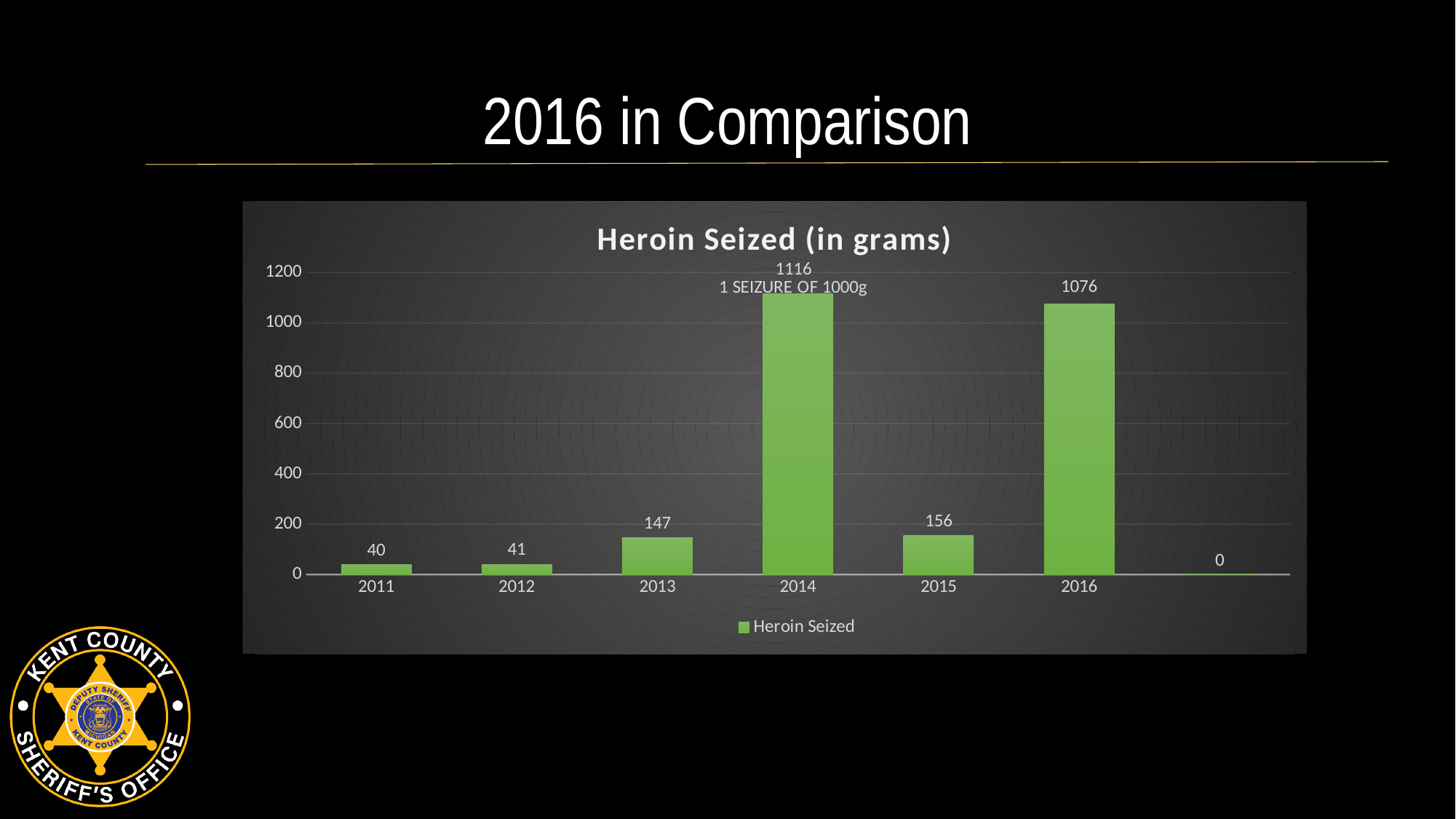
What is the value for 2014 in the Heroin Seized (in grams) chart? 1116 What series name does the legend of the Heroin Seized (in grams) chart show? Heroin Seized What is the value for 2016 in the Heroin Seized (in grams) chart? 1076 Which year has the highest value in the Heroin Seized (in grams) chart? 2014 What kind of chart is the Heroin Seized (in grams) chart? bar chart Is the value for 2016 greater or less than 1000 in the Heroin Seized (in grams) chart? greater Which labelled year has the lowest value in the Heroin Seized (in grams) chart? 2011 How many labelled years are shown on the x axis of the Heroin Seized (in grams) chart? 6 What is the difference between the values for 2016 and 2015 in the Heroin Seized (in grams) chart? 920 Which is larger in the Heroin Seized (in grams) chart, the value for 2013 or the value for 2015? 2015 What is the difference between the values for 2014 and 2016 in the Heroin Seized (in grams) chart? 40 What is the value for 2013 in the Heroin Seized (in grams) chart? 147